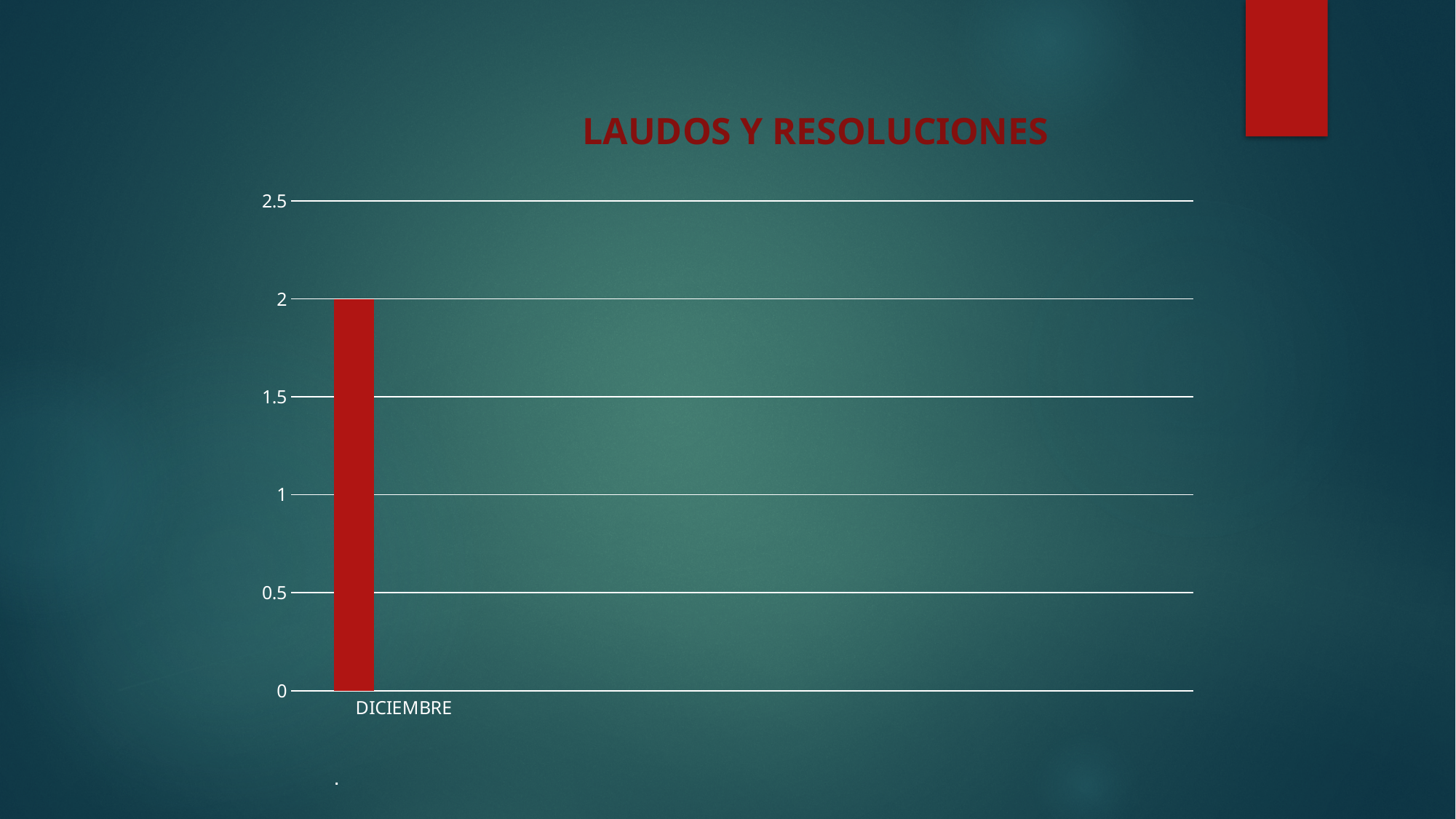
Which category is shown on the x axis? DICIEMBRE How many categories are plotted on the chart? 1 What kind of chart is shown on the slide? bar chart What is the value for DICIEMBRE? 2 What is the title of the chart? LAUDOS Y RESOLUCIONES What is the highest value shown on the vertical axis? 2.5 What colour is the bar in the chart? red Is the value for DICIEMBRE greater or less than 2.5? less Is the value for DICIEMBRE greater or less than 1? greater